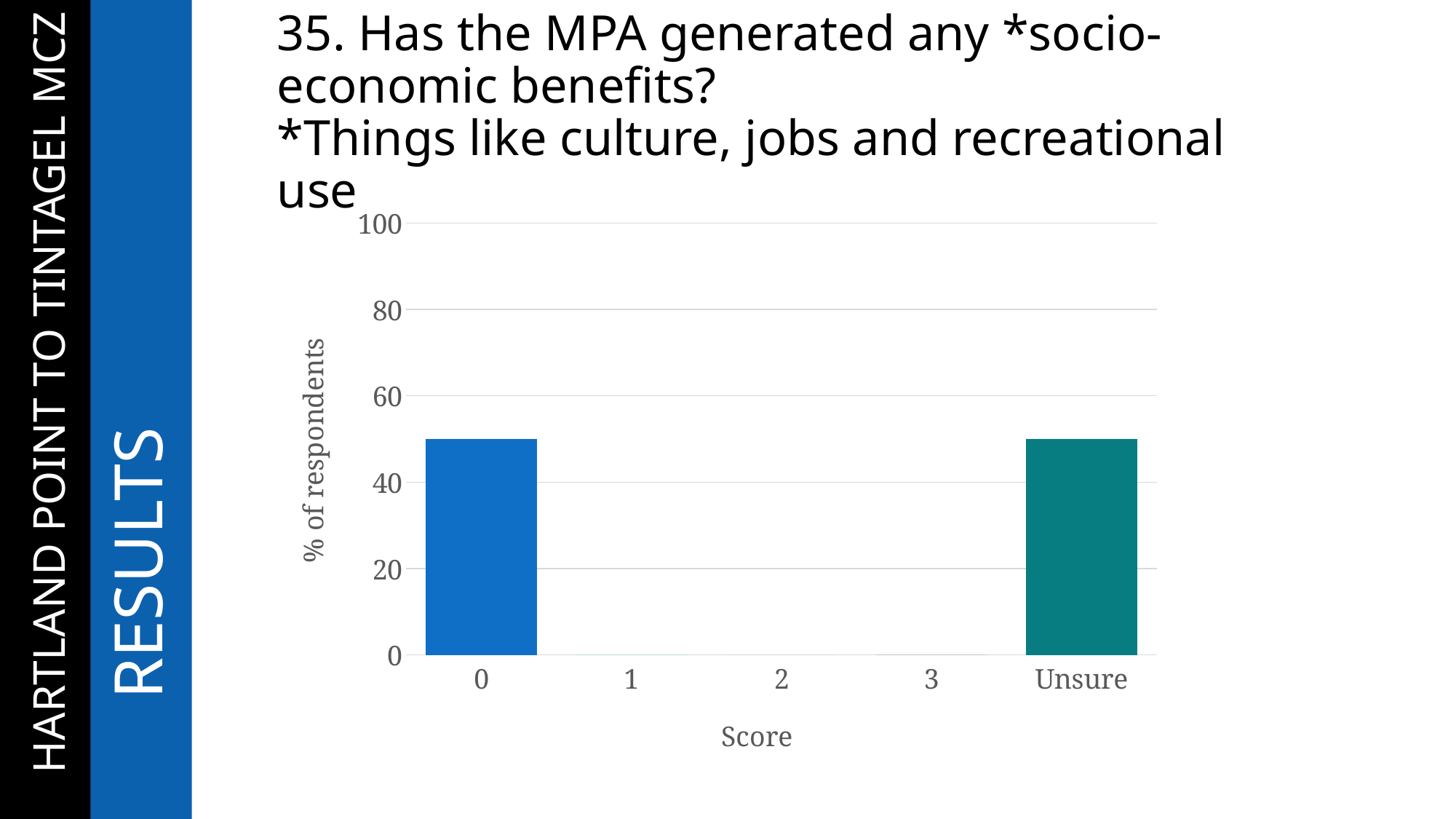
Is the value for Unsure greater or less than 40? greater Which has the larger value, score 0 or score 2? 0 What is the label on the x axis of the chart? Score What kind of chart is shown on the slide? bar chart Is the value for Unsure greater or less than 60? less How many score categories are shown on the x axis? 5 What percentage of respondents gave a score of 1? 0 Is the value for score 0 greater or less than 40? greater What percentage of respondents gave a score of 3? 0 Which has the larger value, score 3 or Unsure? Unsure What is the label on the y axis of the chart? % of respondents